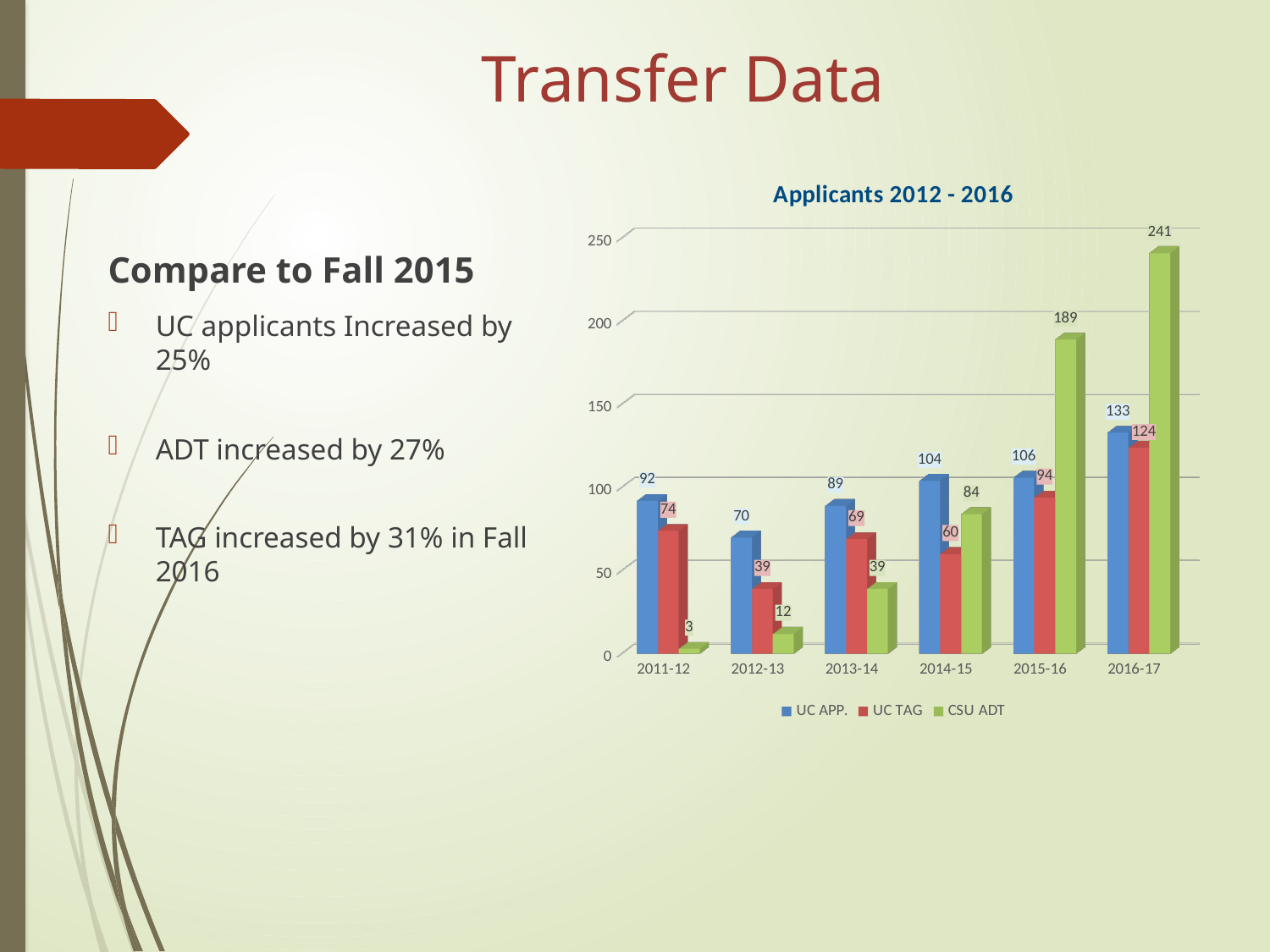
Which year has the lowest UC APP. value? 2012-13 Is the CSU ADT value for 2016-17 greater or less than 200? greater What is the title of the chart? Applicants 2012 - 2016 What is the UC APP. value for 2016-17? 133 What is the UC TAG value for 2012-13? 39 What kind of chart is shown on the slide? Bar chart What is the difference between the CSU ADT values for 2016-17 and 2015-16? 52 Which is larger in 2014-15, UC APP. or CSU ADT? UC APP. How many year categories are shown on the x axis? 6 Which year has the highest CSU ADT value? 2016-17 How many series does the legend list? 3 What is the CSU ADT value for 2015-16? 189